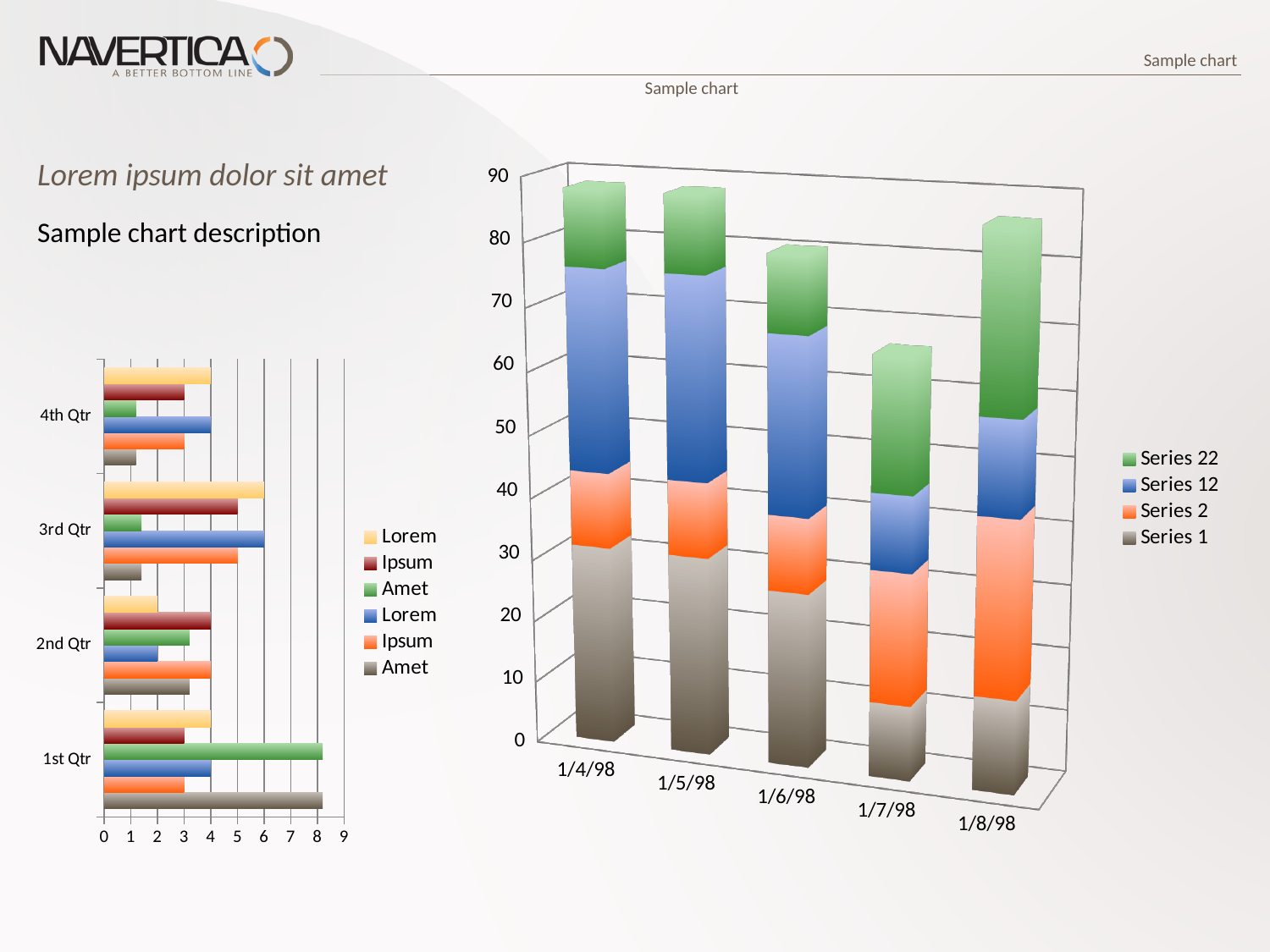
In the chart on the left of the slide, is the value of the gray Amet bar for 1st Qtr greater or less than 7? greater In the chart on the left of the slide, is the value of the yellow Lorem bar for 2nd Qtr greater or less than 3? less In the chart on the right of the slide, is the stacked total for 1/7/98 greater or less than 70? less What kind of chart is the chart on the right of the slide? bar chart How many categories does the chart on the right of the slide show along the x axis? 5 In the chart on the right of the slide, which date has the lowest stacked total? 1/7/98 How many series does the legend of the chart on the left of the slide list? 6 In the chart on the left of the slide, which quarter has the longest gray Amet bar? 1st Qtr What kind of chart is the chart on the left of the slide? bar chart How many categories does the chart on the left of the slide show? 4 How many series does the legend of the chart on the right of the slide list? 4